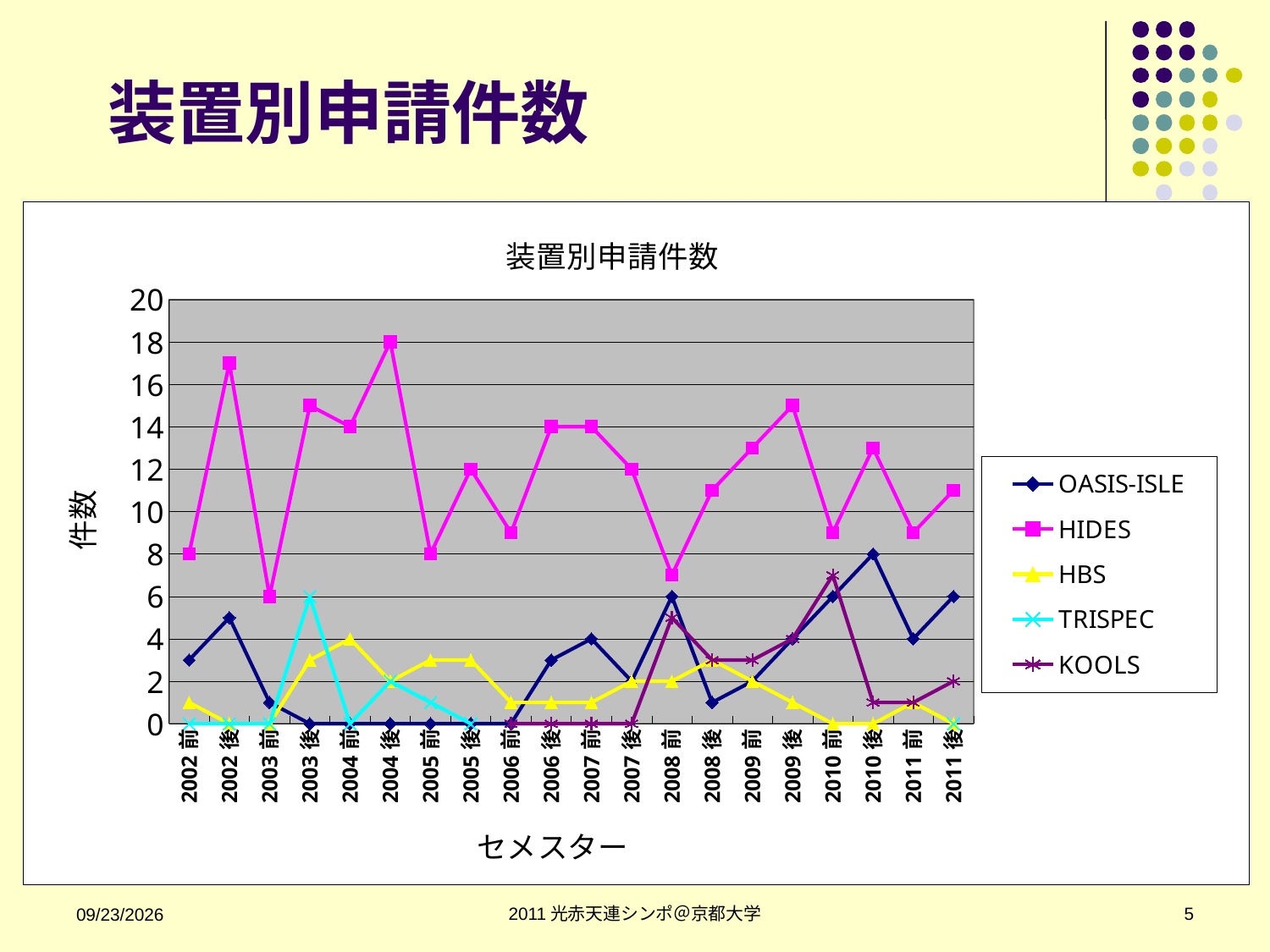
In 2010後, which is larger, HIDES or OASIS-ISLE? HIDES What kind of chart is shown on the slide? line chart In which semester does HIDES reach its highest value? 2004後 What is the title of the x axis? セメスター Is the value for HIDES in 2002後 greater or less than 16? greater How many series does the legend list? 5 What is the value for OASIS-ISLE in 2010後? 8 What is the value for TRISPEC in 2003後? 6 In which semester does OASIS-ISLE reach its highest value? 2010後 What is the value for HIDES in 2004後? 18 How many semesters are shown along the x axis? 20 Which series reaches the highest value on the chart? HIDES